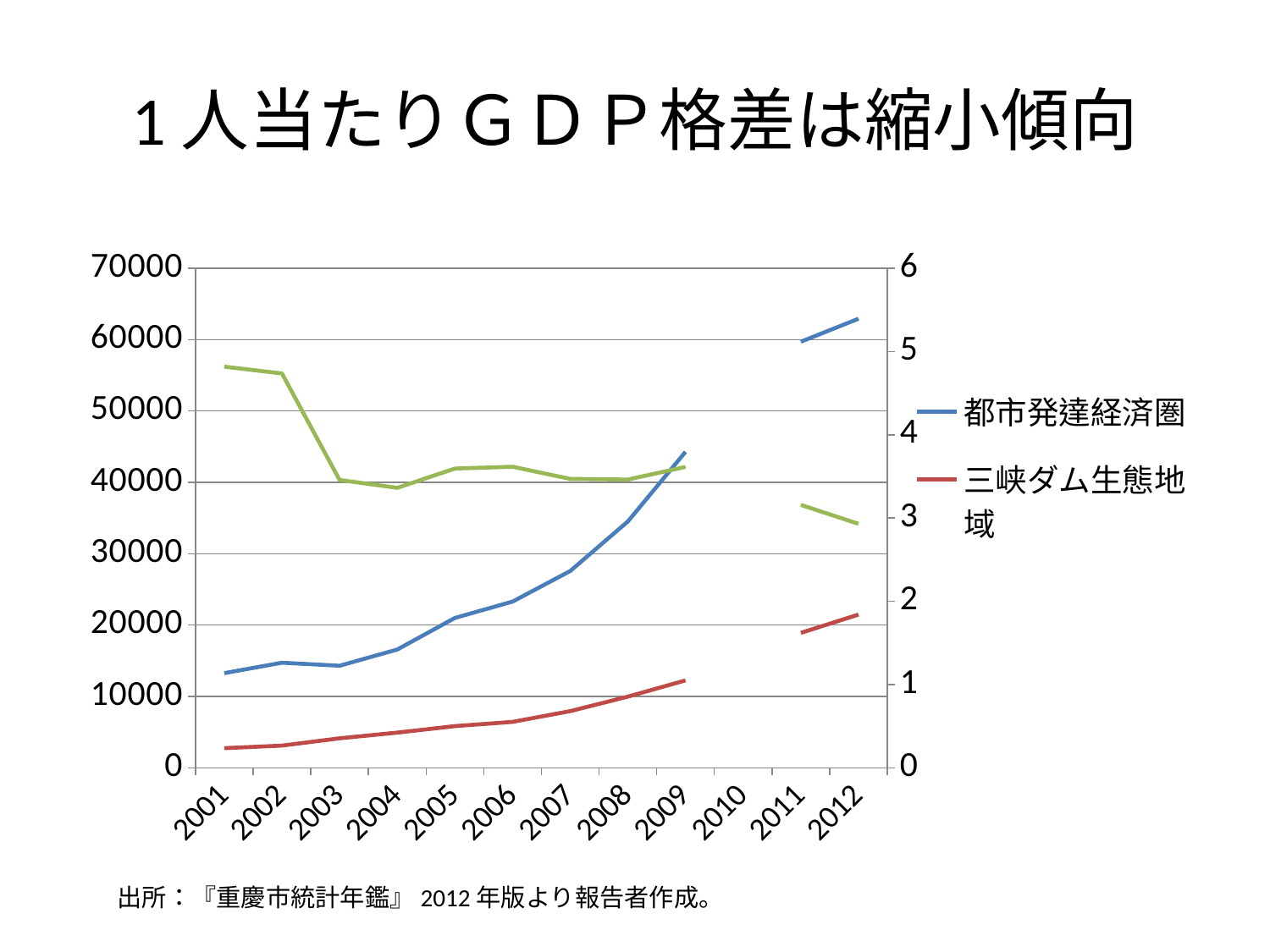
What is the title of the slide? 1人当たりGDP格差は縮小傾向 What kind of chart is shown on the slide? line chart Does the 都市発達経済圏 line rise or fall from 2001 to 2009? rise Is the value for 三峡ダム生態地域 in 2001 greater or less than 10000? less How many series does the legend list? 2 Is the value for 三峡ダム生態地域 in 2009 greater or less than 10000? greater Is the value for 都市発達経済圏 in 2001 greater or less than 20000? less How many years are labelled on the x axis? 12 Which year on the x axis has no data plotted? 2010 In 2012, which series has the larger value, 都市発達経済圏 or 三峡ダム生態地域? 都市発達経済圏